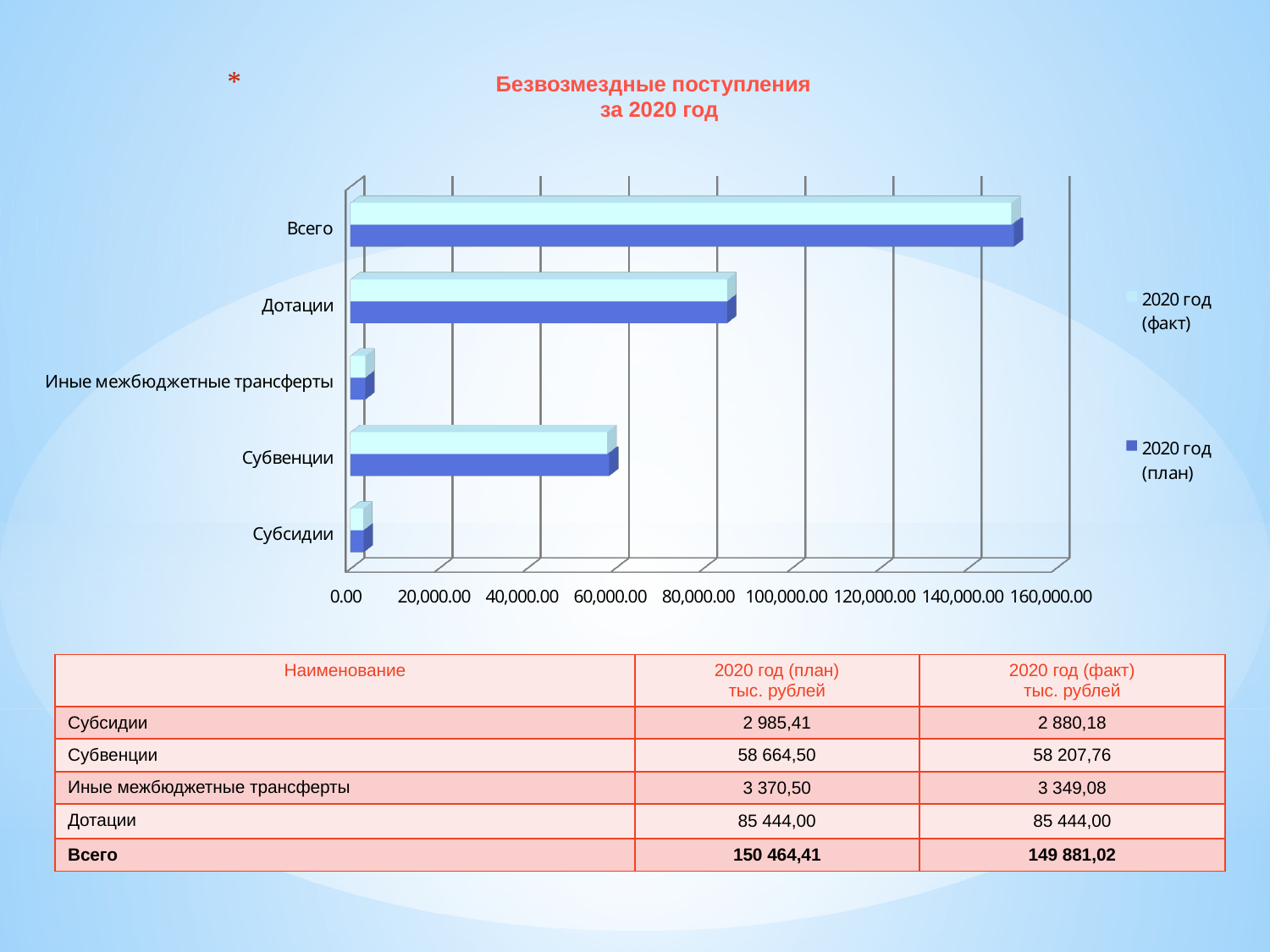
According to the slide, what is the 2020 год (план) value for Дотации? 85 444,00 According to the slide, what is the 2020 год (факт) value for Субвенции? 58 207,76 Excluding Всего, which category has the highest 2020 год (факт) value? Дотации According to the slide, what is the 2020 год (план) value for Всего? 150 464,41 Is the 2020 год (план) value for Субвенции greater or less than 40,000.00? greater What kind of chart is shown on the slide? bar chart Excluding Всего, which category has the lowest 2020 год (план) value? Субсидии Which is larger for Иные межбюджетные трансферты: the 2020 год (план) value or the 2020 год (факт) value? 2020 год (план) How many categories are shown on the chart's vertical axis? 5 What is the difference between the 2020 год (план) and 2020 год (факт) values for Всего? 583,39 How many series does the chart legend list? 2 What is the title of the chart? Безвозмездные поступления за 2020 год